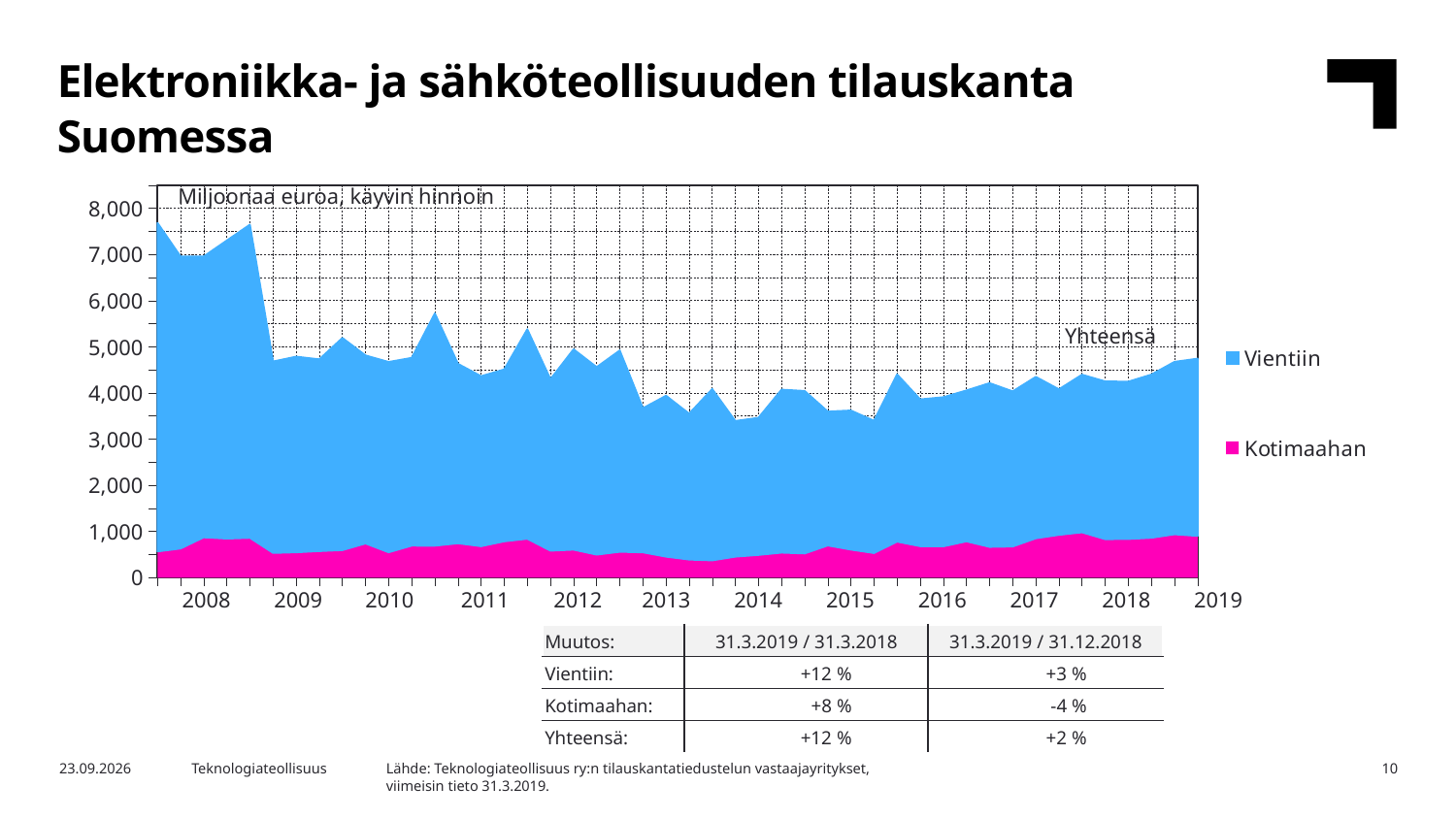
What unit label is printed at the top of the chart? Miljoonaa euroa, käyvin hinnoin Is the total (Yhteensä) value in 2014 greater or less than 5,000? less How many year labels are shown on the x axis? 12 Is the Kotimaahan value in 2018 greater or less than 1,000? less How many series does the chart legend list? 2 What are the two series named in the chart legend? Vientiin and Kotimaahan Does the total order backlog rise or fall between 2008 and 2014? fall What is the highest value shown on the y axis? 8,000 Is the total (Yhteensä) value at the start of 2008 greater or less than 6,000? greater Which series is larger throughout the chart, Vientiin or Kotimaahan? Vientiin What kind of chart is shown on the slide? Stacked area chart